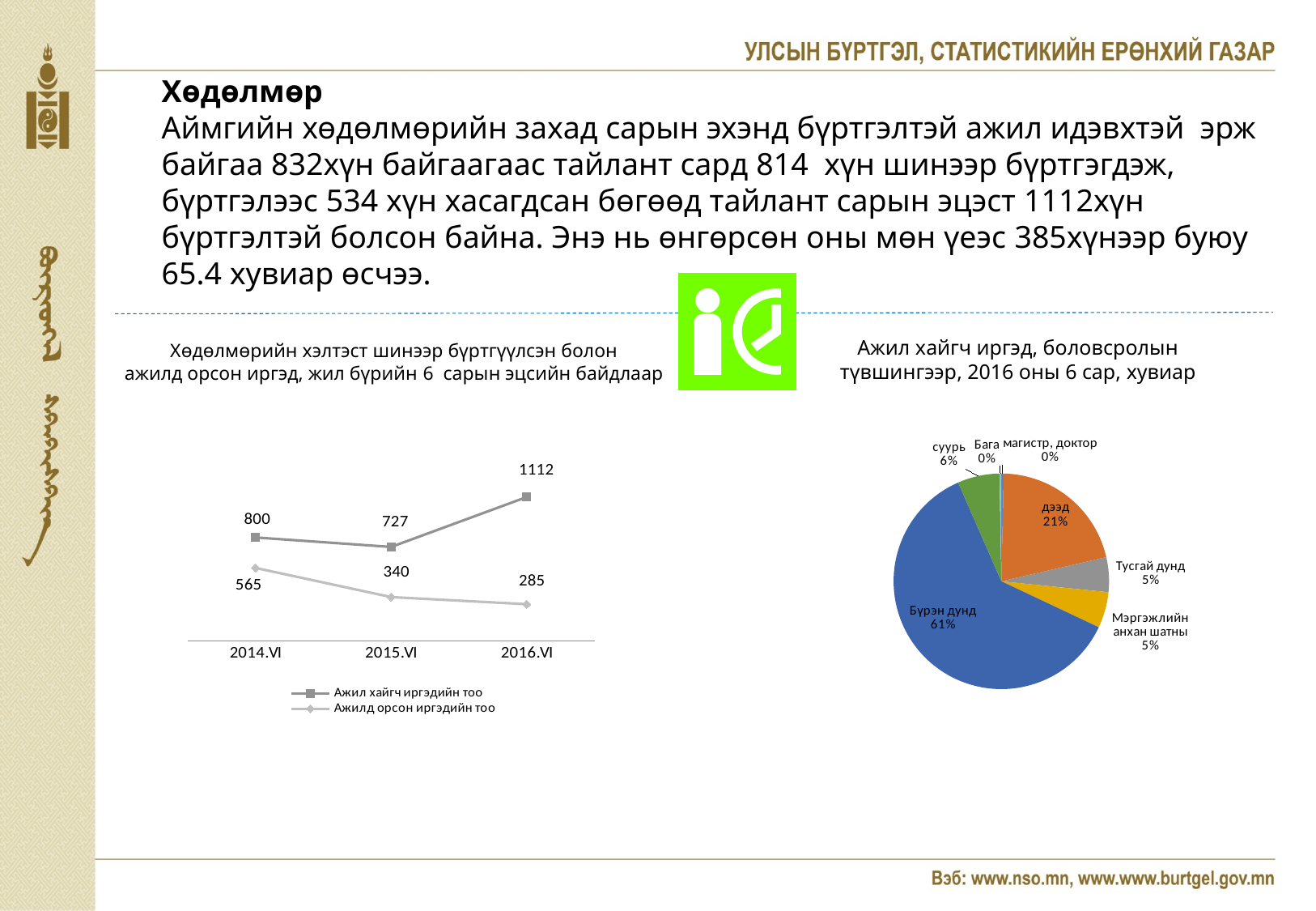
In the pie chart on the right, which category has the largest share? Бүрэн дунд In the pie chart on the right, what is the value for 'дээд'? 21% In the pie chart on the right, what share does 'Бүрэн дунд' have? 61% What kind of chart is the chart on the left? line chart In the line chart on the left, what is the value of 'Ажил хайгч иргэдийн тоо' for 2016.VI? 1112 In the line chart on the left, in which period is 'Ажил хайгч иргэдийн тоо' lowest? 2015.VI In the line chart on the left, how many periods are shown on the x axis? 3 In the line chart on the left, does 'Ажилд орсон иргэдийн тоо' rise or fall from 2014.VI to 2016.VI? fall In the line chart on the left, what is the difference between 'Ажил хайгч иргэдийн тоо' and 'Ажилд орсон иргэдийн тоо' in 2016.VI? 827 In the line chart on the left, how many series does the legend list? 2 In the line chart on the left, what is the value of 'Ажилд орсон иргэдийн тоо' for 2015.VI? 340 In the pie chart on the right, which is larger: 'суурь' or 'Тусгай дунд'? суурь